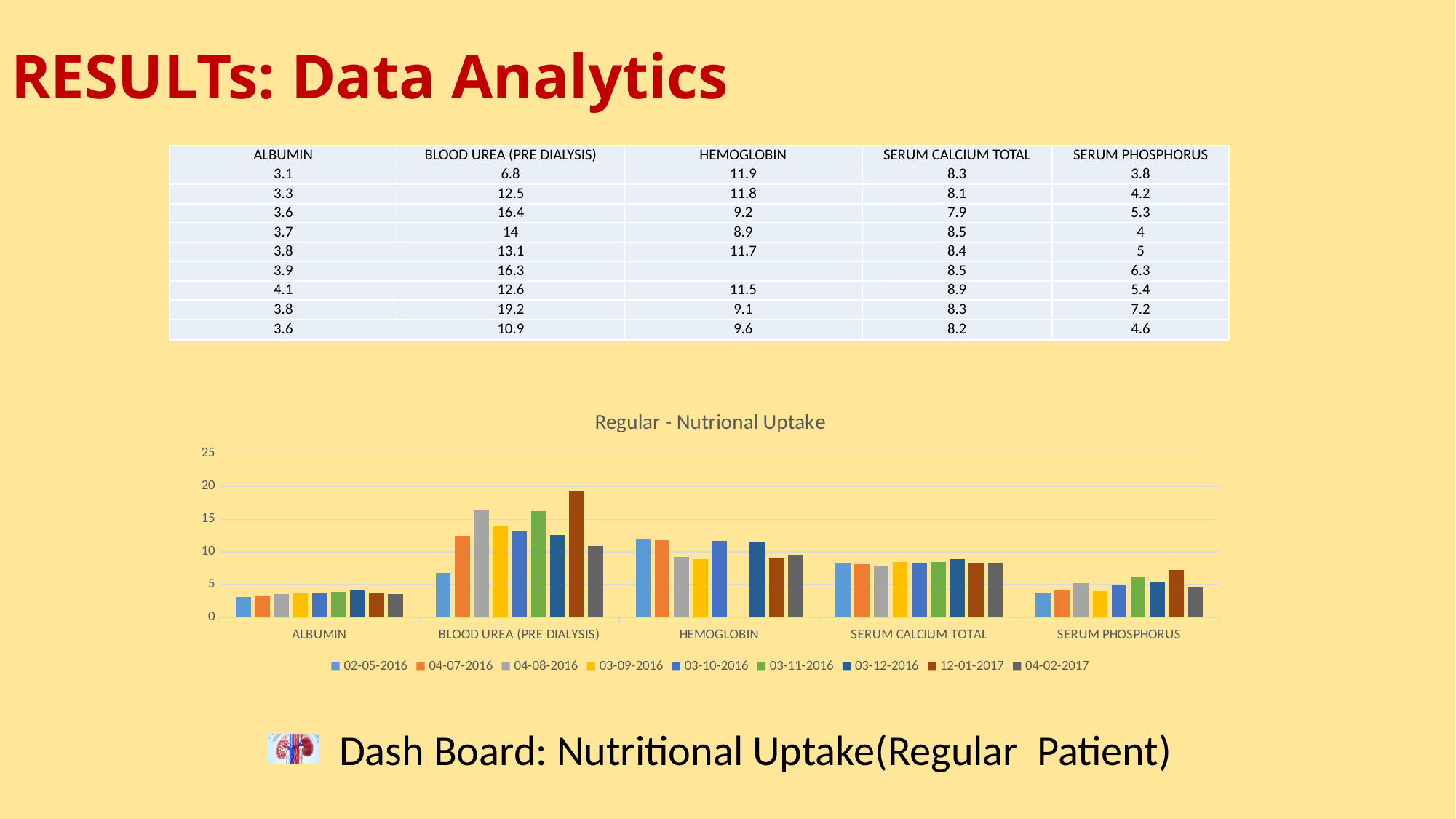
In the "Regular - Nutrional Uptake" chart, which series has the highest value for SERUM PHOSPHORUS? 12-01-2017 In the "Regular - Nutrional Uptake" chart, is the value for 02-05-2016 in ALBUMIN greater or less than 5? less How many series does the legend of the "Regular - Nutrional Uptake" chart list? 9 In the "Regular - Nutrional Uptake" chart, which series has no bar plotted for HEMOGLOBIN? 03-11-2016 In the "Regular - Nutrional Uptake" chart, is the value for 03-12-2016 in SERUM CALCIUM TOTAL greater or less than 5? greater In the "Regular - Nutrional Uptake" chart, which category contains the tallest bar? BLOOD UREA (PRE DIALYSIS) What kind of chart is shown under the title "Regular - Nutrional Uptake"? bar chart In the "Regular - Nutrional Uptake" chart, which is larger: the 02-05-2016 value for HEMOGLOBIN or the 02-05-2016 value for SERUM PHOSPHORUS? HEMOGLOBIN In the "Regular - Nutrional Uptake" chart, is the value for 12-01-2017 in BLOOD UREA (PRE DIALYSIS) greater or less than 15? greater In the "Regular - Nutrional Uptake" chart, which series has the highest value for BLOOD UREA (PRE DIALYSIS)? 12-01-2017 How many categories are shown on the x axis of the "Regular - Nutrional Uptake" chart? 5 In the "Regular - Nutrional Uptake" chart, which series has the lowest value for BLOOD UREA (PRE DIALYSIS)? 02-05-2016